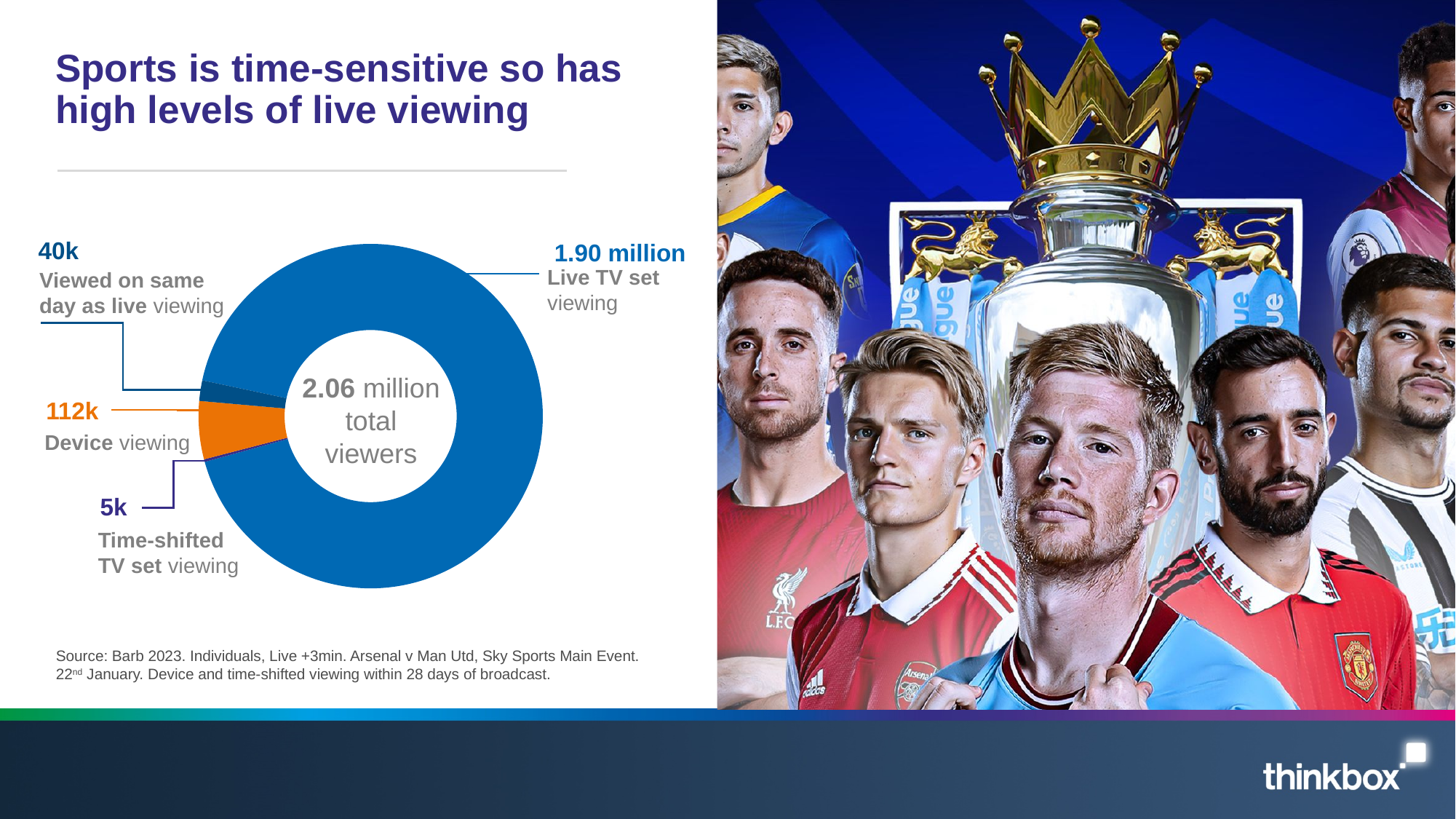
What is the total number of viewers shown in the centre of the donut chart? 2.06 million total viewers What is the value for Live TV set viewing in the donut chart? 1.90 million What is the value for Device viewing in the donut chart? 112k How many viewing categories are shown in the donut chart? 4 What is the value for Time-shifted TV set viewing in the donut chart? 5k Which is larger, Device viewing or Time-shifted TV set viewing? Device viewing Which viewing category has the largest segment in the donut chart? Live TV set viewing Which viewing category has the smallest segment in the donut chart? Time-shifted TV set viewing What kind of chart is shown on the slide? Donut (pie) chart What is the difference between Device viewing and same-day-as-live viewing? 73k What is the difference between same-day-as-live viewing and Time-shifted TV set viewing? 34k What is the value for viewing on the same day as live in the donut chart? 40k